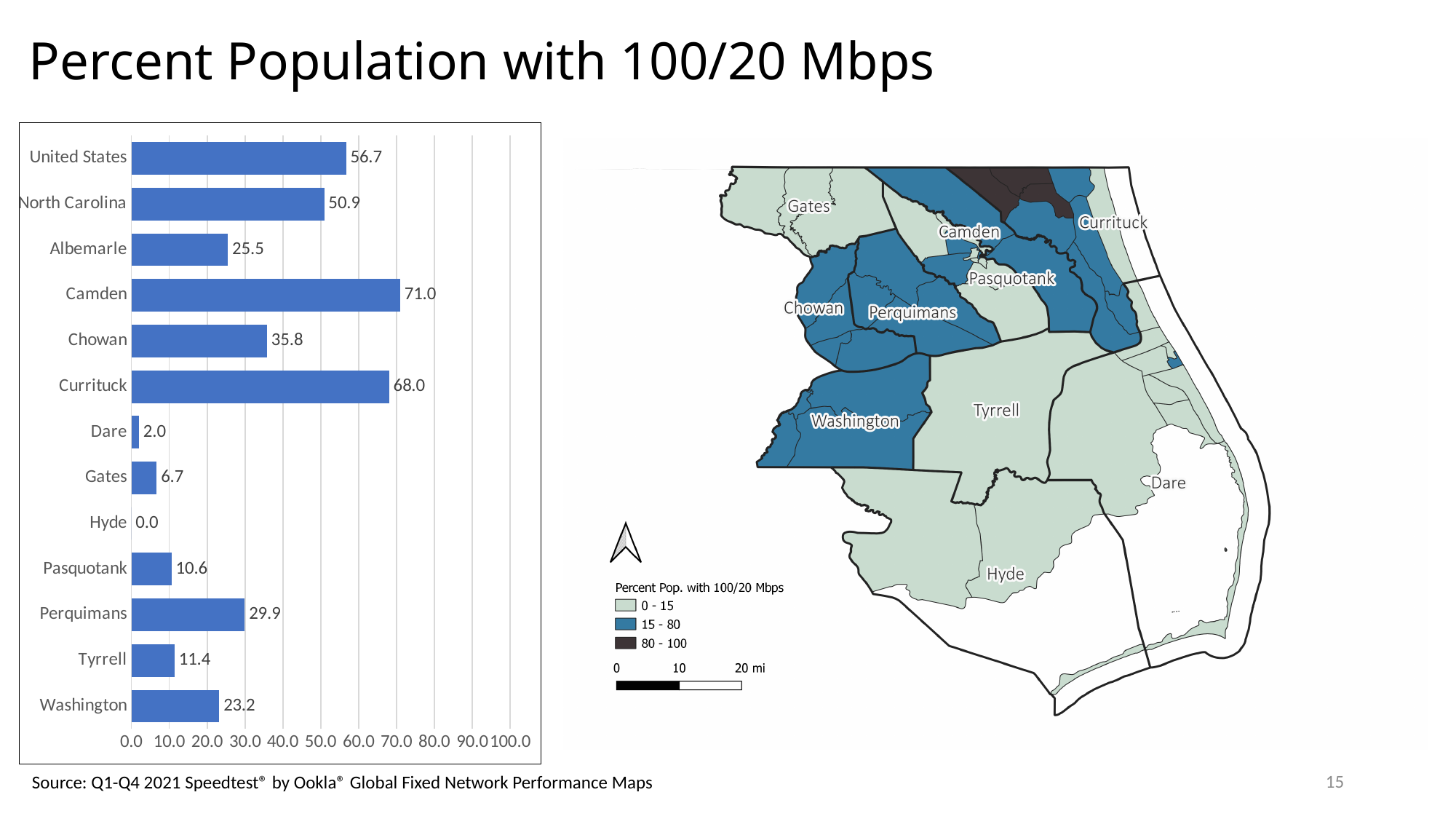
What is the difference between the values for Camden and Currituck in the bar chart? 3.0 What is the value for North Carolina in the bar chart? 50.9 What is the title of the slide? Percent Population with 100/20 Mbps Which has a larger value in the bar chart, Chowan or Perquimans? Chowan What is the value for Camden in the bar chart? 71.0 Which category has the lowest value in the bar chart? Hyde Which category has the highest value in the bar chart? Camden What is the value for Washington in the bar chart? 23.2 How many categories are shown in the bar chart? 13 Is the value for Albemarle in the bar chart greater or less than 30.0? less What is the difference between the values for United States and North Carolina in the bar chart? 5.8 What kind of chart is shown on the left of the slide? bar chart